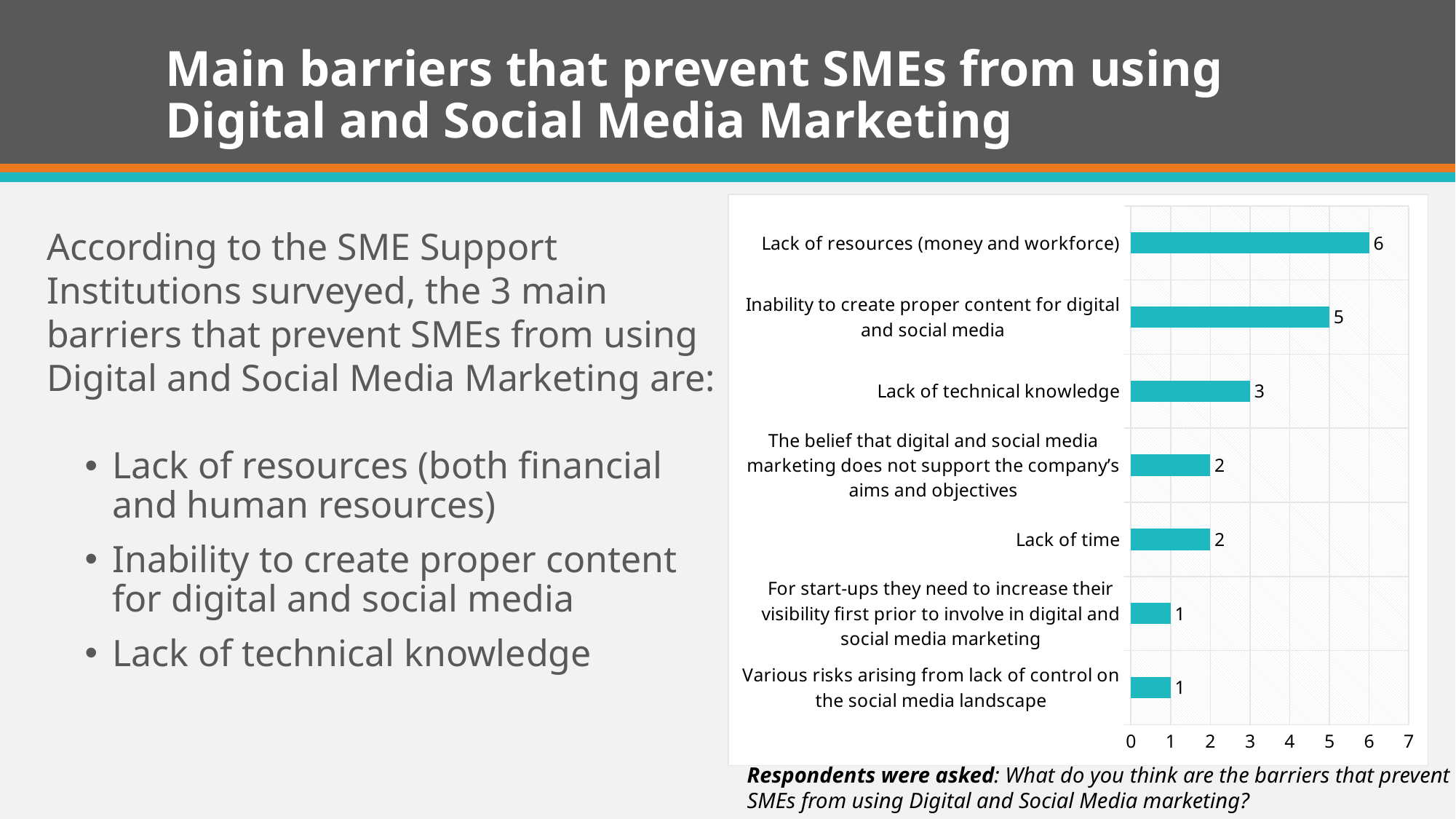
What kind of chart is shown on the slide? Bar chart Which has a larger value: "Lack of technical knowledge" or "Lack of time"? Lack of technical knowledge What is the difference between the values for "Lack of resources (money and workforce)" and "Lack of technical knowledge"? 3 What value is shown for "Lack of resources (money and workforce)"? 6 Which barrier has the highest value in the chart? Lack of resources (money and workforce) Is the value for "Inability to create proper content for digital and social media" greater or less than 4? greater What value is shown for "Lack of technical knowledge"? 3 How many barrier categories are shown in the chart? 7 What is the highest value shown on the horizontal axis of the chart? 7 What is the value for "Various risks arising from lack of control on the social media landscape"? 1 What value is shown for "Lack of time"? 2 What value is shown for "Inability to create proper content for digital and social media"? 5